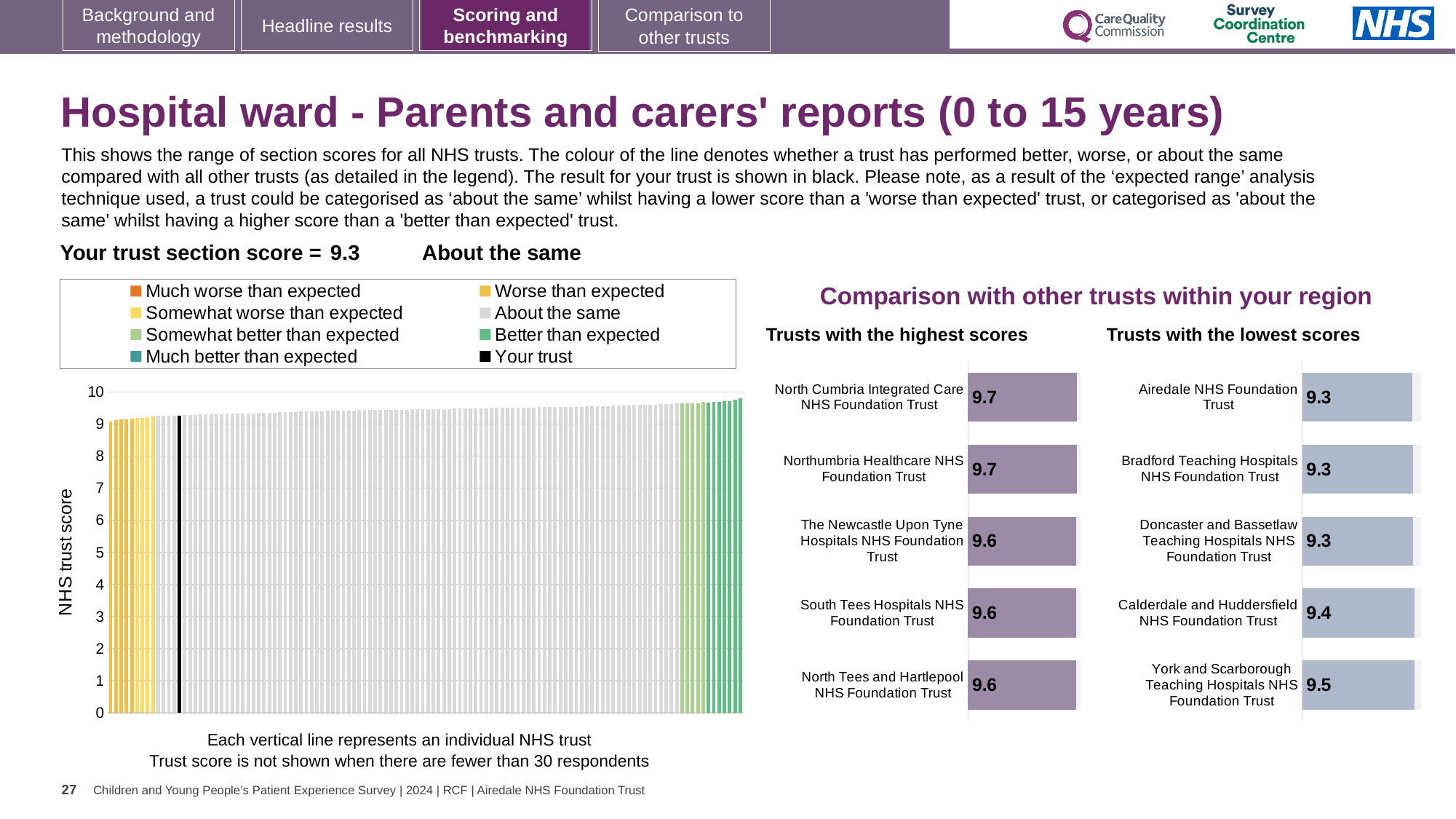
In the large chart on the left, do the trust scores rise or fall from left to right along the x axis? Rise How many trusts are shown in the 'Trusts with the lowest scores' chart? 5 In the 'Trusts with the highest scores' chart, what is the difference between the scores of Northumbria Healthcare NHS Foundation Trust and North Tees and Hartlepool NHS Foundation Trust? 0.1 In the 'Trusts with the lowest scores' chart, which has the larger score: Calderdale and Huddersfield NHS Foundation Trust or Bradford Teaching Hospitals NHS Foundation Trust? Calderdale and Huddersfield NHS Foundation Trust In the 'Trusts with the lowest scores' chart, which trust has the highest score? York and Scarborough Teaching Hospitals NHS Foundation Trust How many entries does the legend above the large chart on the left list? 8 What kind of chart is the large chart on the left showing NHS trust scores? Bar chart In the 'Trusts with the highest scores' chart, what is the score for South Tees Hospitals NHS Foundation Trust? 9.6 How many trusts are shown in the 'Trusts with the highest scores' chart? 5 In the 'Trusts with the highest scores' chart, what is the score for North Cumbria Integrated Care NHS Foundation Trust? 9.7 In the 'Trusts with the lowest scores' chart, what is the difference between the scores of York and Scarborough Teaching Hospitals NHS Foundation Trust and Airedale NHS Foundation Trust? 0.2 In the 'Trusts with the lowest scores' chart, what is the score for Calderdale and Huddersfield NHS Foundation Trust? 9.4